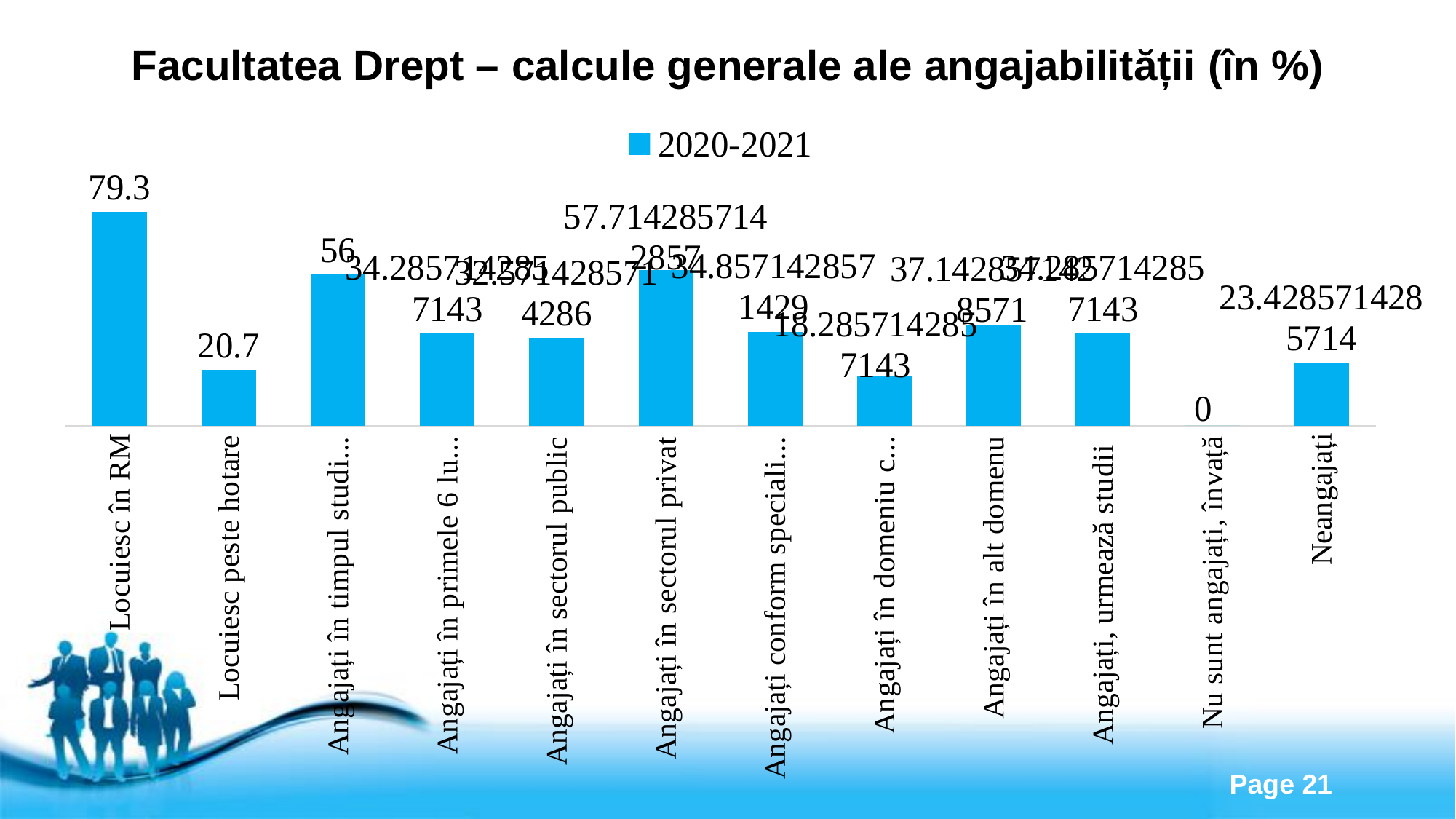
How many categories are shown in the chart? 12 Which is larger, the value for "Angajați în sectorul public" or "Angajați în sectorul privat"? Angajați în sectorul privat What is the difference between the values for "Locuiesc în RM" and "Locuiesc peste hotare"? 58.6 What is the value for "Locuiesc peste hotare"? 20.7 What is the value for "Nu sunt angajați, învață"? 0 What is the legend entry of the chart? 2020-2021 What kind of chart is shown on the slide? Bar chart Which category has the lowest value? Nu sunt angajați, învață What is the value for "Locuiesc în RM"? 79.3 How many series does the legend list? 1 Which category has the highest value? Locuiesc în RM Which is larger, the value for "Neangajați" or "Angajați în alt domenu"? Angajați în alt domenu